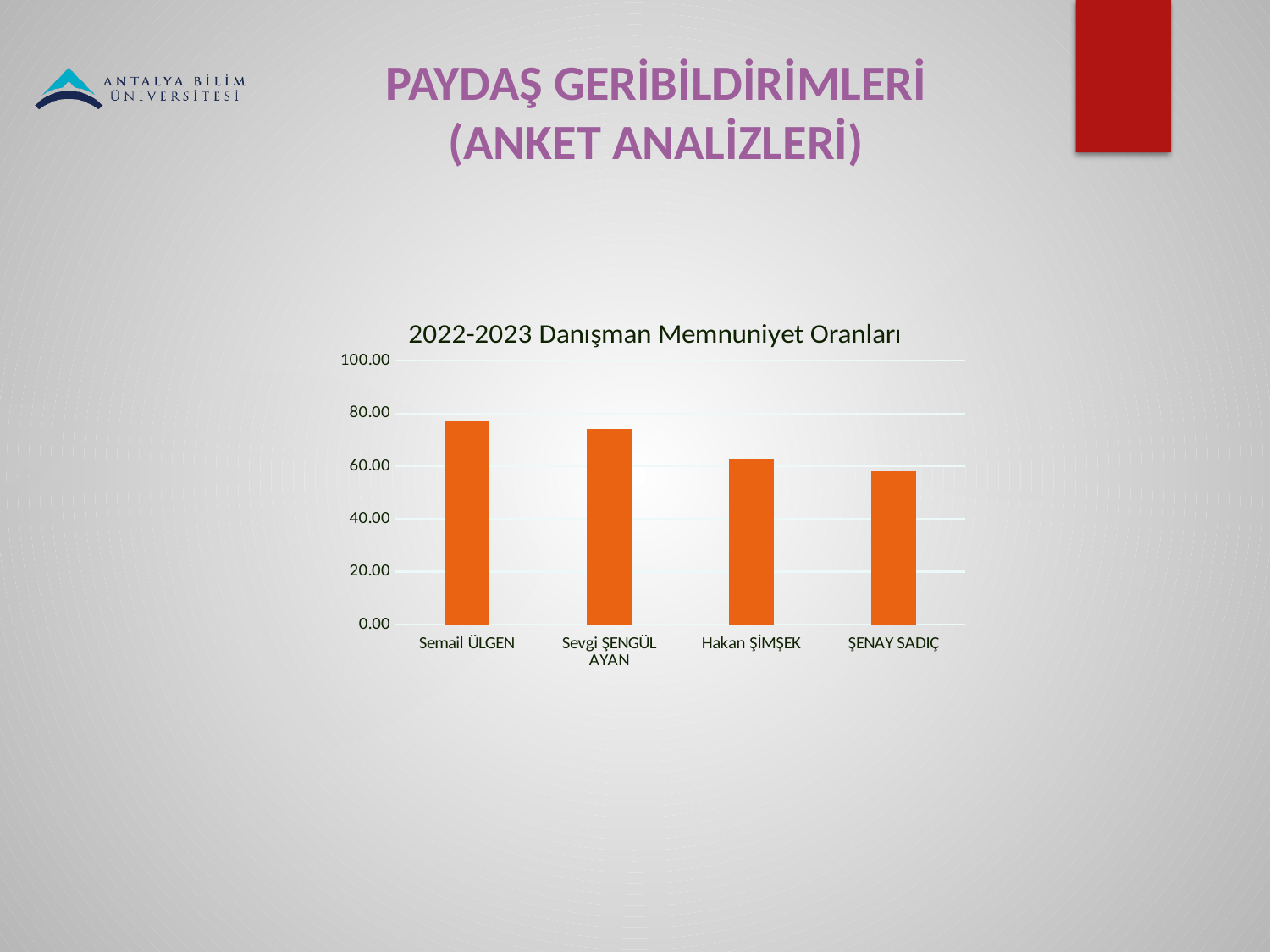
Is the value for Semail ÜLGEN greater or less than 60.00? greater Is the value for ŞENAY SADIÇ greater or less than 80.00? less How many advisors (categories) are shown in the chart? 4 What is the title of the chart? 2022-2023 Danışman Memnuniyet Oranları Is the value for Sevgi ŞENGÜL AYAN greater or less than 80.00? less Do the values rise or fall from left to right across the chart? fall What colour are the bars in the chart? orange Which is larger, the value for Semail ÜLGEN or the value for Hakan ŞİMŞEK? Semail ÜLGEN What kind of chart is shown on the slide? bar chart Which advisor has the highest satisfaction rate in the chart? Semail ÜLGEN Which advisor has the lowest satisfaction rate in the chart? ŞENAY SADIÇ